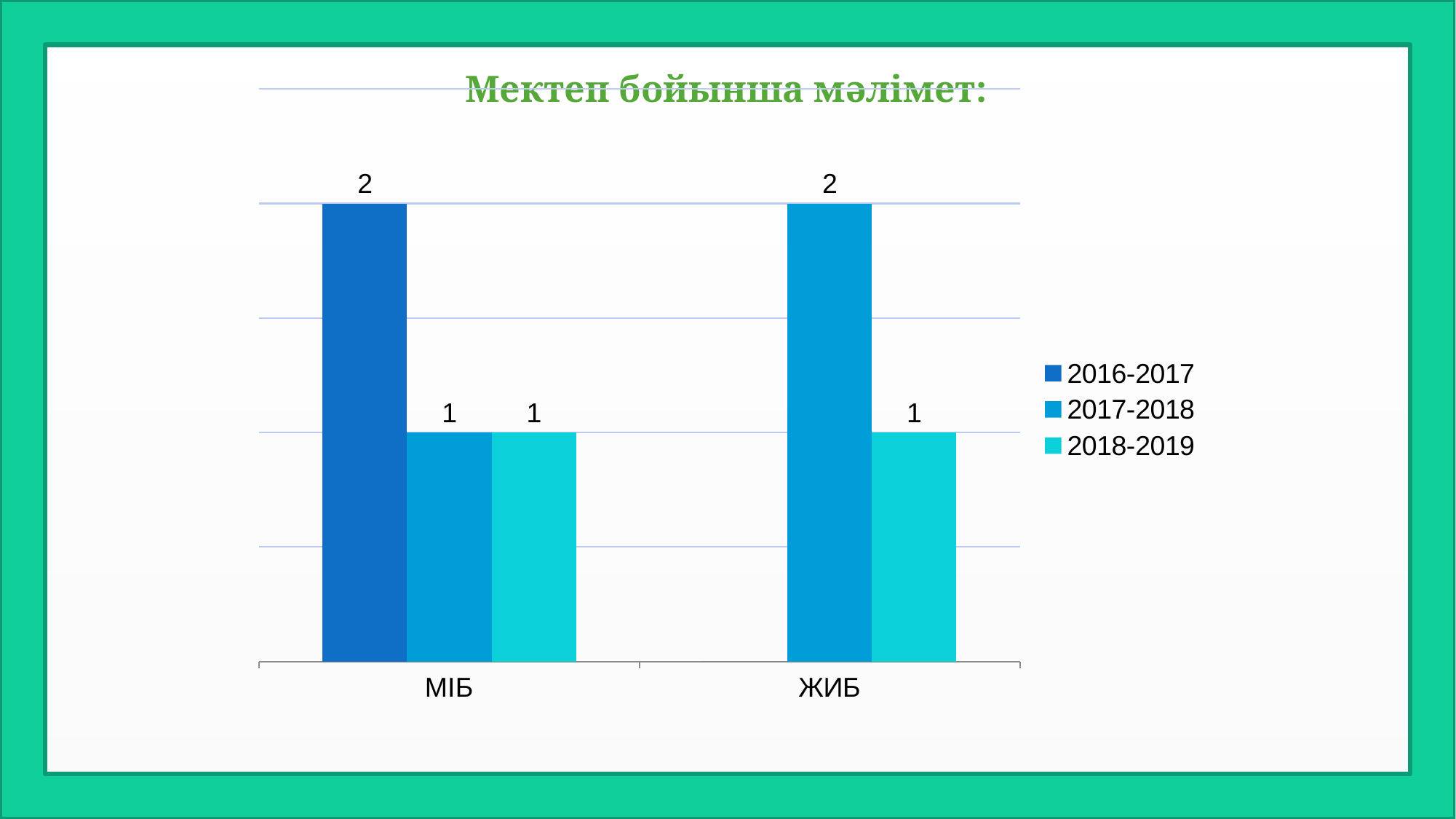
What is the difference between the 2016-2017 and 2018-2019 values for МІБ? 1 What is the value for МІБ in the 2016-2017 series? 2 How many series does the legend list? 3 What is the value for МІБ in the 2017-2018 series? 1 What is the value for ЖИБ in the 2018-2019 series? 1 Which series has the highest value for ЖИБ? 2017-2018 What is the value for МІБ in the 2018-2019 series? 1 How many categories are shown on the x axis? 2 Which series has the highest value for МІБ? 2016-2017 What kind of chart is shown on the slide? bar chart What is the value for ЖИБ in the 2017-2018 series? 2 Which is larger for ЖИБ: the 2017-2018 value or the 2018-2019 value? 2017-2018